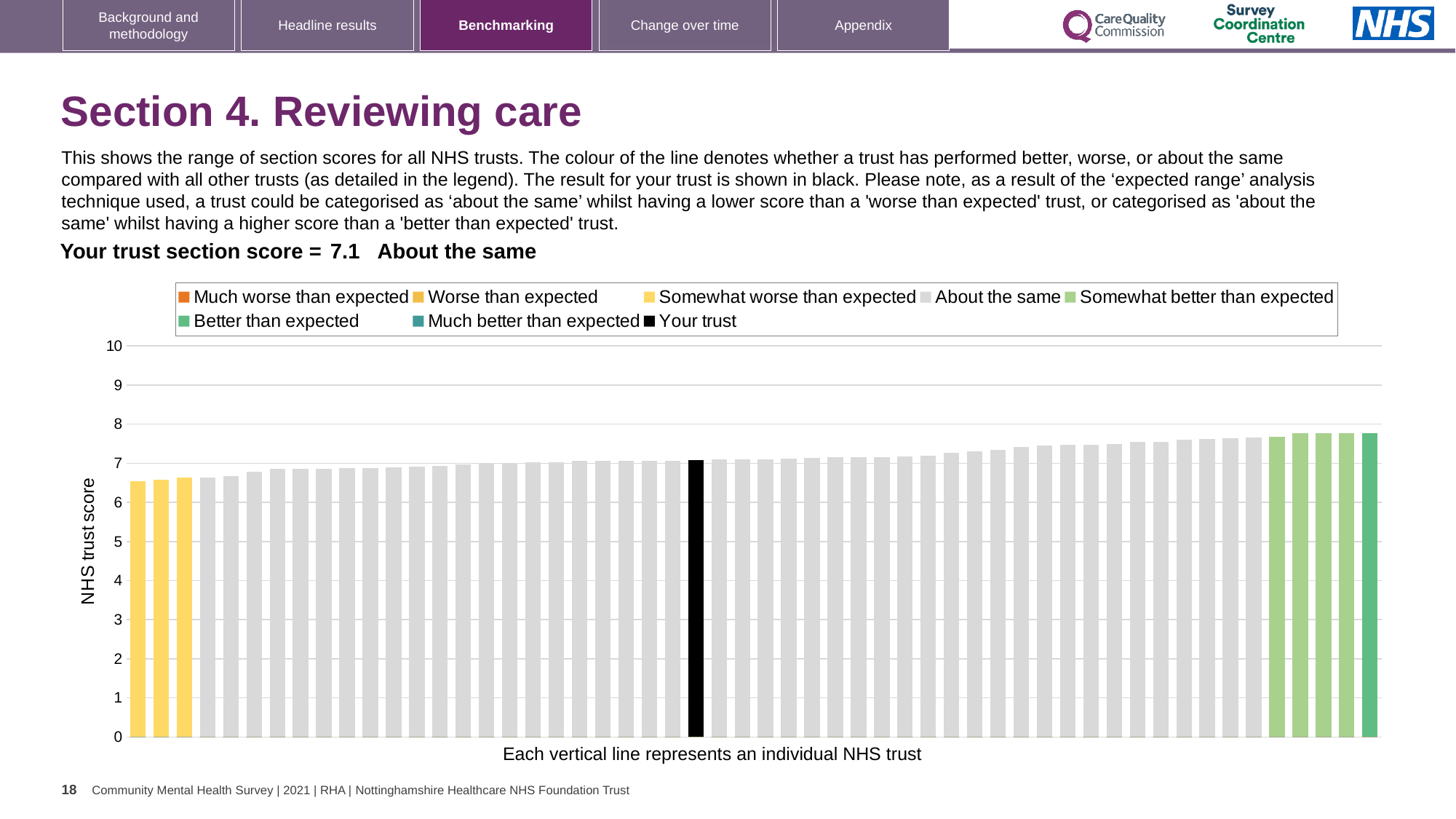
What type of chart is shown on the slide? bar chart What colour is the bar representing your trust? black Is the value of the highest bar in the chart greater or less than 7? greater What is the section score for your trust shown on the slide? 7.1 How many bars are coloured yellow (Somewhat worse than expected)? 3 How many entries does the chart legend list? 8 Is the value of the lowest bar in the chart greater or less than 7? less Which performance category is your trust placed in for this section? About the same Is the value of the highest bar in the chart greater or less than 8? less Which is larger, the leftmost bar or the rightmost bar? the rightmost bar What is the label on the vertical axis of the chart? NHS trust score Do the bar values rise or fall from left to right along the x axis? rise